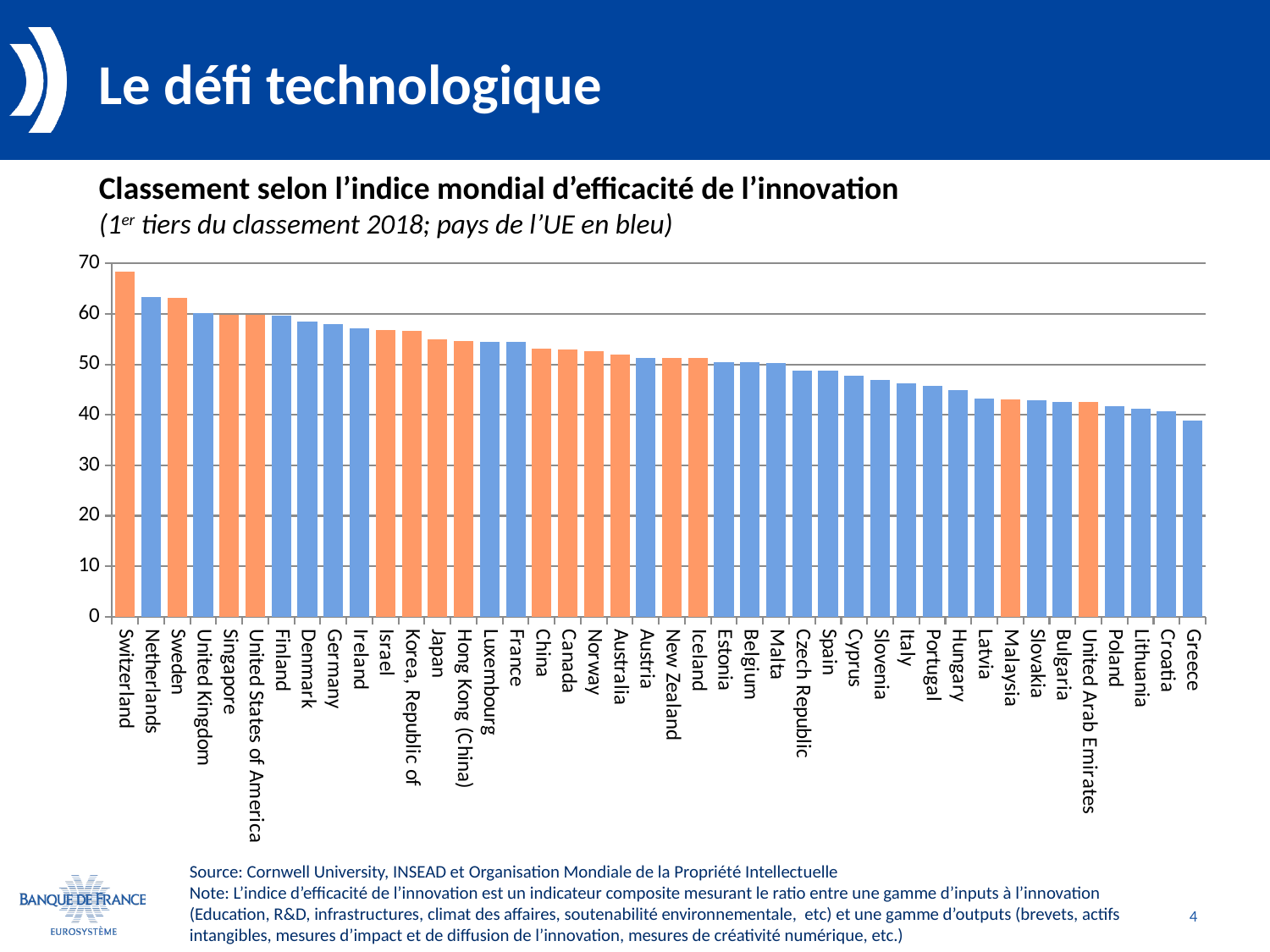
Do the values rise or fall from left to right along the x axis? fall Is the value for Germany greater or less than 60? less Is the value for Greece greater or less than 40? less What kind of chart is shown on the slide? bar chart Which has the larger value, Japan or Spain? Japan Is the value for Switzerland greater or less than 60? greater How many countries are shown in the chart? 42 Which country has the lowest value in the chart? Greece According to the subtitle, what colour are the EU countries shown in? blue Which country has the highest value in the chart? Switzerland